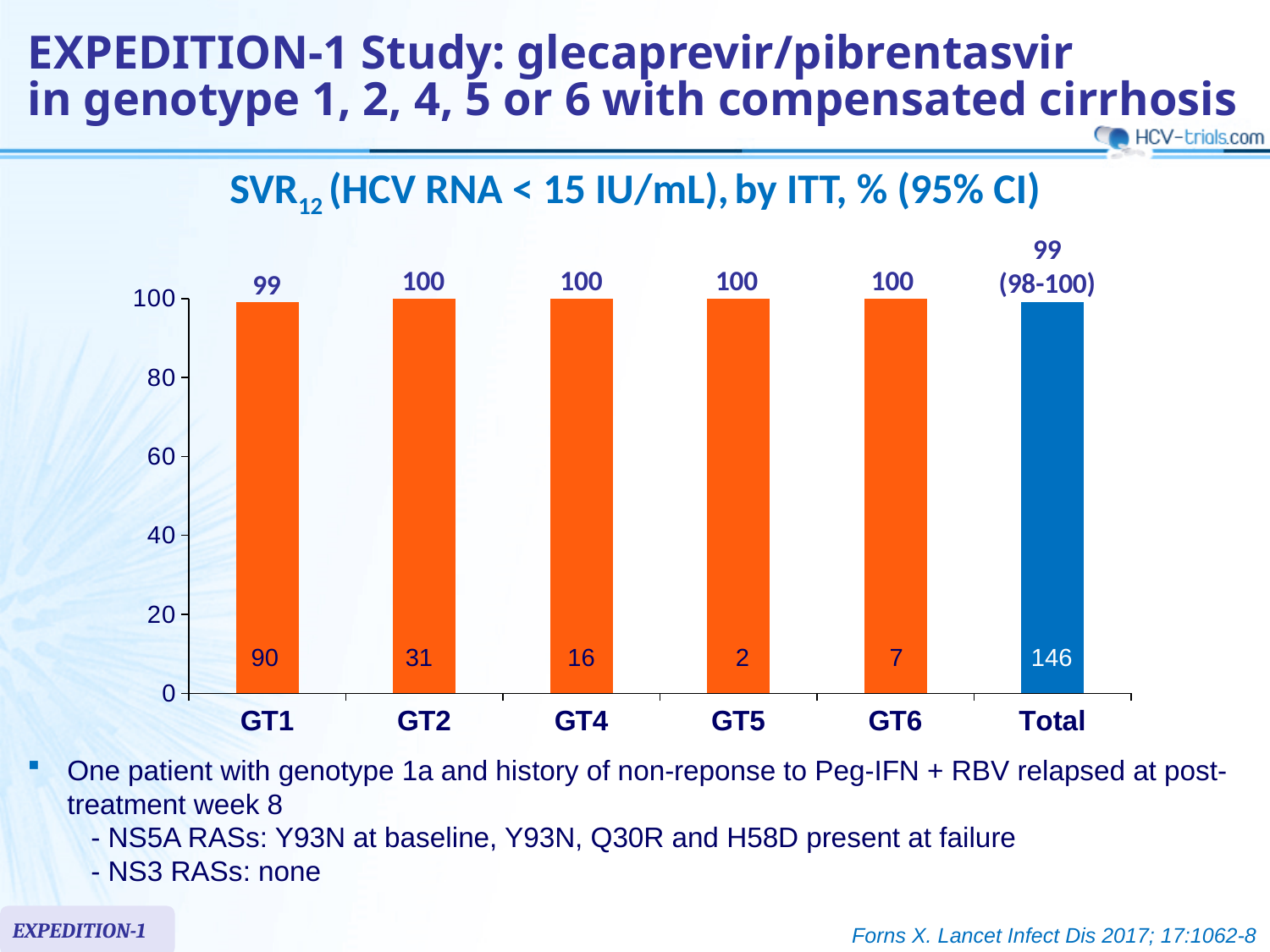
Which is larger, the SVR12 value for GT5 or for GT1? GT5 Which bar is shown in a different colour (blue) from the others? Total What is the difference between the SVR12 values for GT2 and GT1? 1 Which genotype group has the lowest SVR12 value? GT1 How many bars are shown in the chart? 6 How many patients are shown inside the Total bar? 146 What is the SVR12 value for the Total group? 99 What kind of chart is shown on the slide? Bar chart How many patients are shown inside the GT2 bar? 31 What is the SVR12 value for GT1? 99 What is the SVR12 value for GT4? 100 What is the 95% CI shown for the Total bar? 98-100